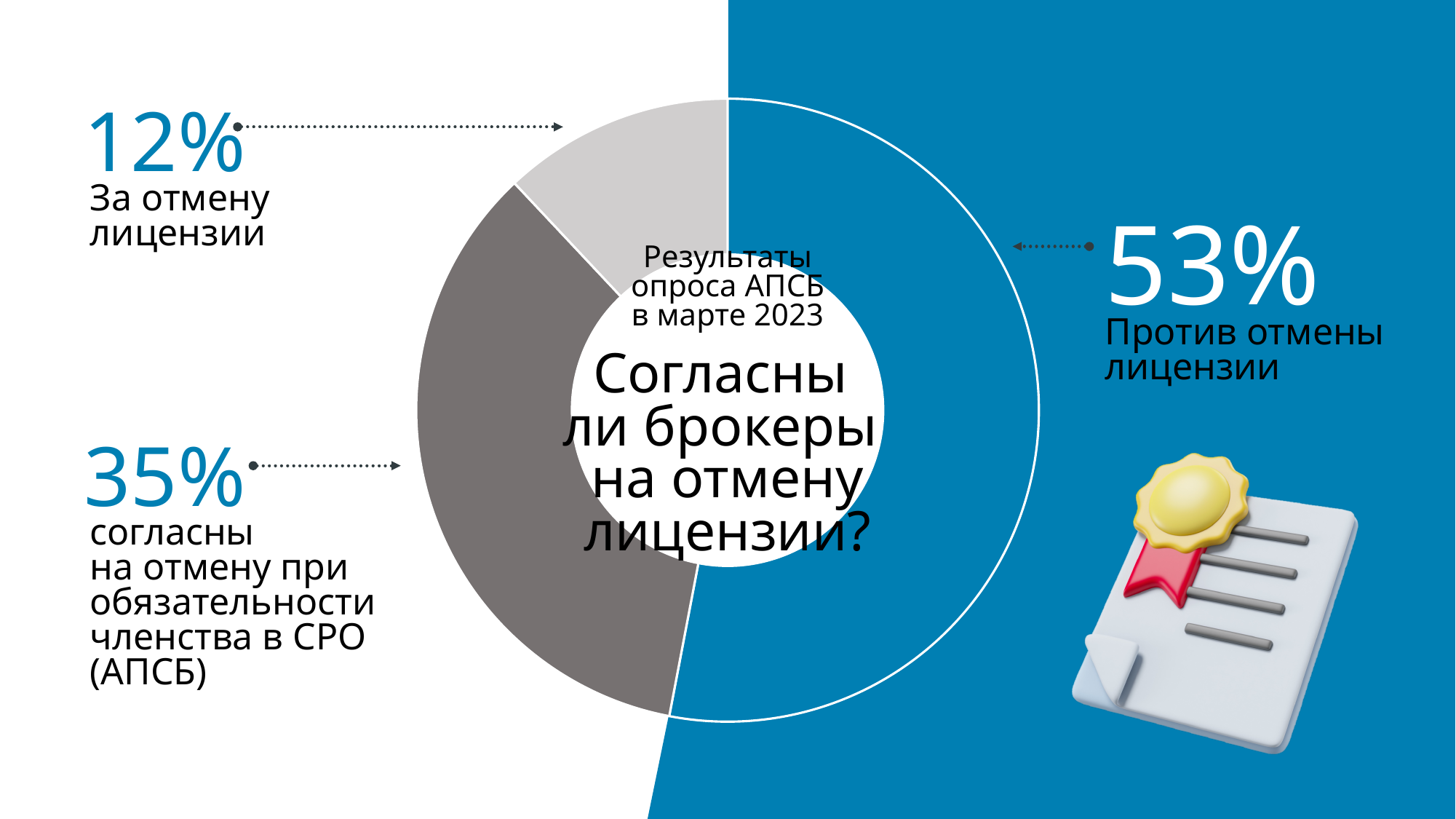
What share of brokers are for cancelling the licence (За отмену лицензии)? 12% Which is larger: the share for cancelling the licence or the share agreeing to cancellation with mandatory SRO membership? Share agreeing with mandatory SRO membership (35%) What question is written in the centre of the chart? Согласны ли брокеры на отмену лицензии? Which response option has the smallest share in the chart? За отмену лицензии When was the survey whose results are shown conducted? March 2023 (в марте 2023) What kind of chart is shown on the slide? Donut (pie) chart How many segments does the chart have? 3 What share of brokers are against cancelling the licence (Против отмены лицензии)? 53% What is the difference in percentage points between the 53% and 35% segments? 18 What share of brokers agree to cancellation provided membership in the SRO (АПСБ) is mandatory? 35% What is the difference in percentage points between those against cancelling the licence and those for cancelling it? 41 Which response option has the largest share in the chart? Против отмены лицензии